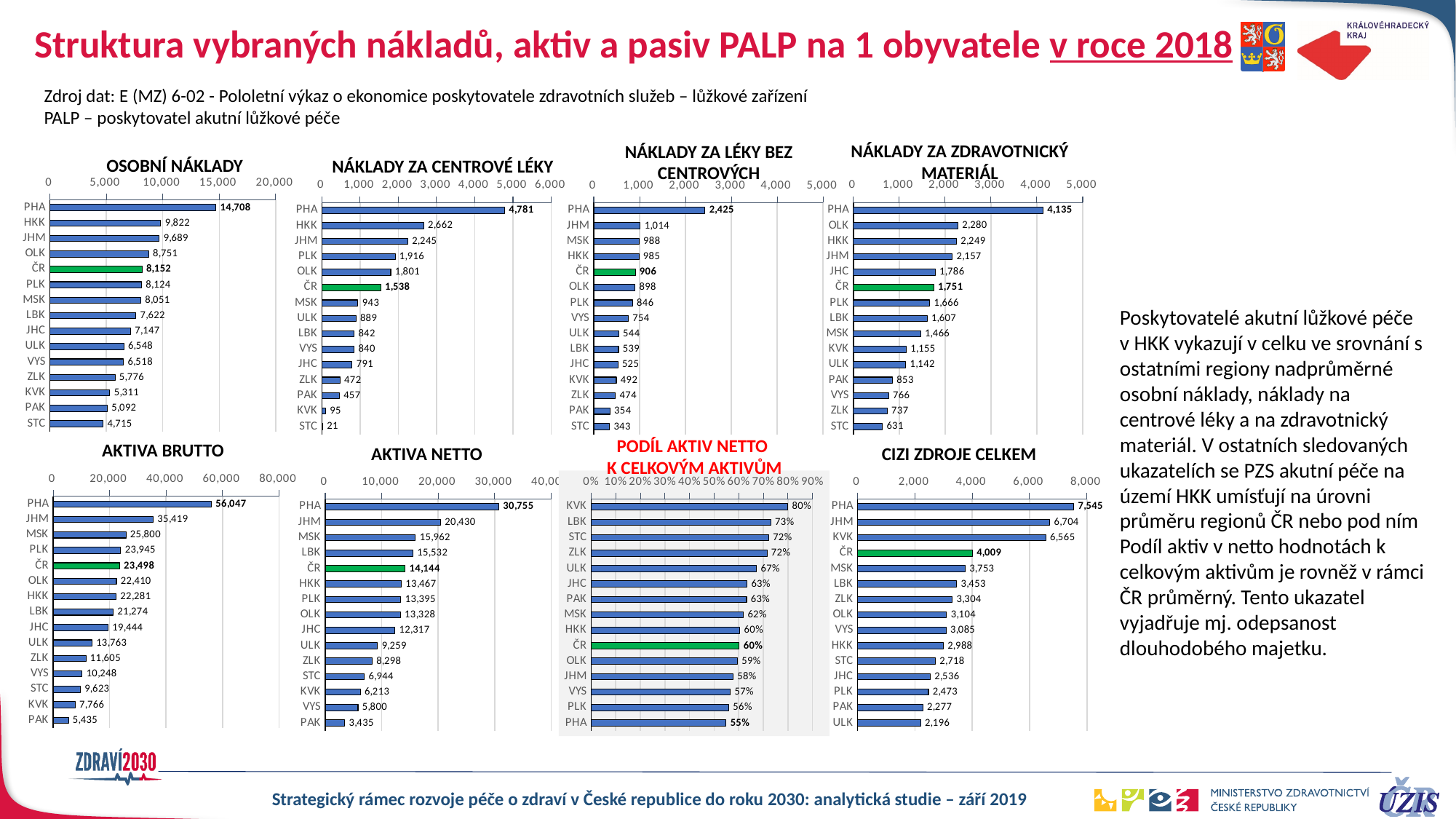
In the PODÍL AKTIV NETTO K CELKOVÝM AKTIVŮM chart, which region has the lowest share? PHA In the NÁKLADY ZA CENTROVÉ LÉKY chart, what is the value for ČR? 1,538 What type of chart is the AKTIVA BRUTTO chart? Bar chart In the PODÍL AKTIV NETTO K CELKOVÝM AKTIVŮM chart, what is the value for KVK? 80% In the NÁKLADY ZA ZDRAVOTNICKÝ MATERIÁL chart, what is the value for OLK? 2,280 In the OSOBNÍ NÁKLADY chart, which region has the lowest value? STC In the OSOBNÍ NÁKLADY chart, what is the value for HKK? 9,822 In the CIZI ZDROJE CELKEM chart, what is the value for ČR? 4,009 In the AKTIVA NETTO chart, which is larger, the value for HKK or the value for LBK? LBK In the AKTIVA BRUTTO chart, how many regions (bars) are shown? 15 In the NÁKLADY ZA LÉKY BEZ CENTROVÝCH chart, which region has the highest value? PHA In the NÁKLADY ZA CENTROVÉ LÉKY chart, what is the difference between PHA and HKK? 2,119